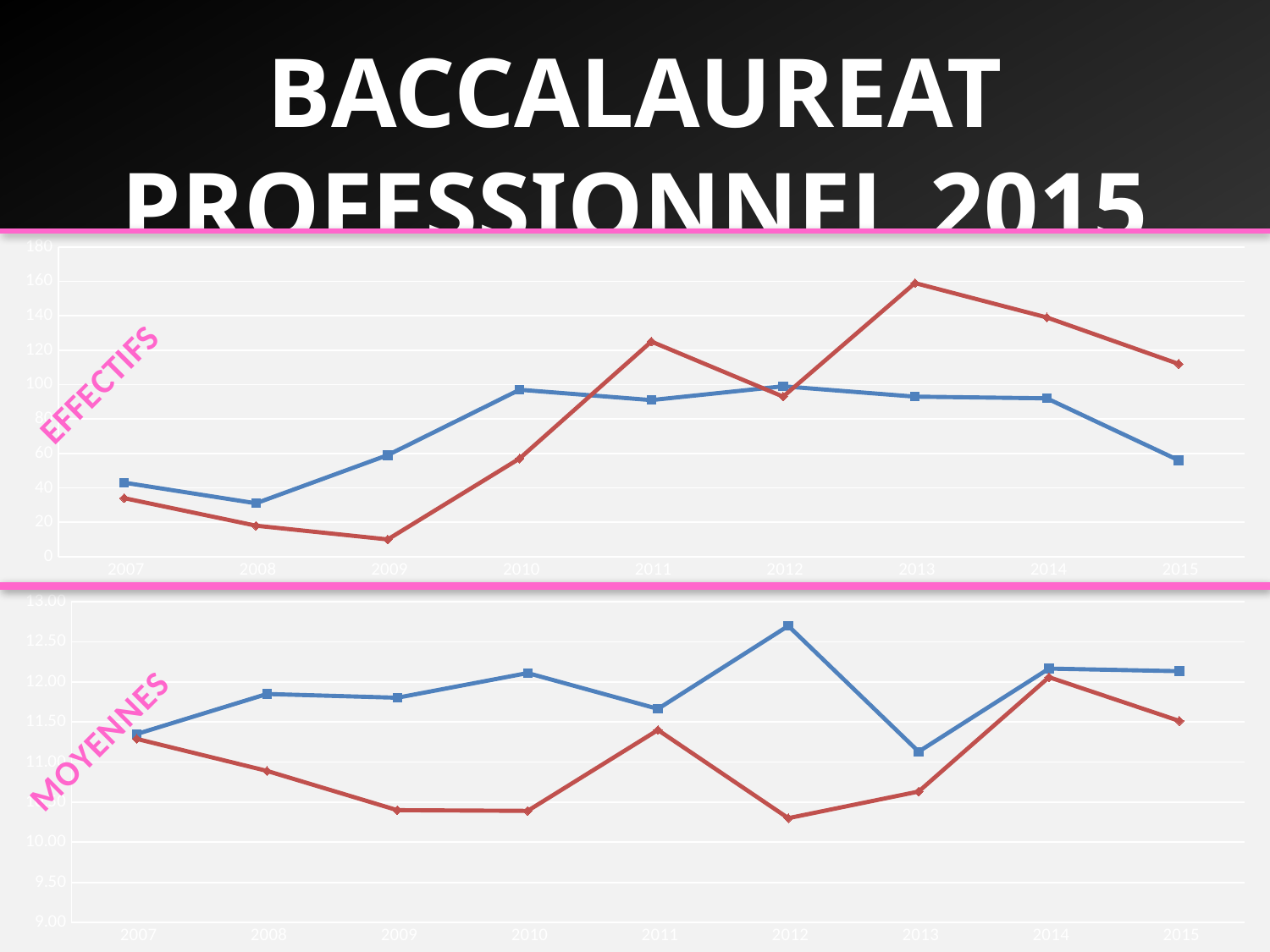
In the MOYENNES chart, is the blue line's value for 2012 greater or less than 12.50? greater In the EFFECTIFS chart, is the red line's value for 2009 greater or less than 20? less In the EFFECTIFS chart, is the red line's value for 2013 greater or less than 140? greater In the MOYENNES chart, which year has the highest value for the blue line? 2012 In the EFFECTIFS chart, does the red line rise or fall from 2013 to 2015? fall How many years are shown on the x axis of the MOYENNES chart at the bottom of the slide? 9 What is the label written beside the bottom chart on the slide? MOYENNES In the EFFECTIFS chart, which line has the larger value in 2013, the blue line or the red line? the red line What kind of chart is the EFFECTIFS chart at the top of the slide? line chart In the EFFECTIFS chart, which year has the lowest value for the red line? 2009 In the EFFECTIFS chart, which year has the highest value for the red line? 2013 In the MOYENNES chart, which line has the larger value in 2009, the blue line or the red line? the blue line